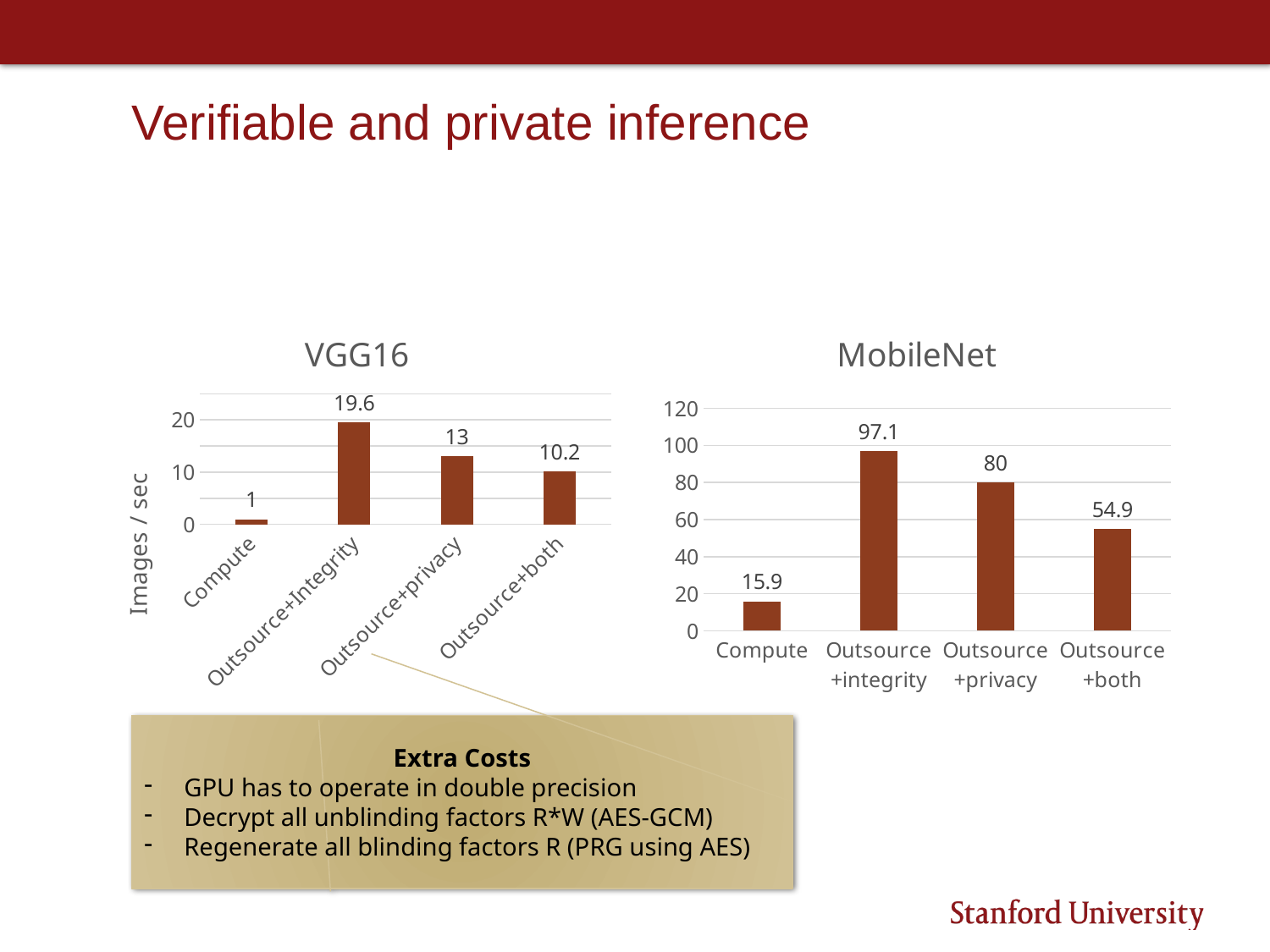
In the MobileNet chart, what is the value for Compute? 15.9 In the MobileNet chart, what is the difference between Outsource+integrity and Outsource+both? 42.2 In the MobileNet chart, which category has the highest value? Outsource+integrity In the MobileNet chart, is the value for Compute greater or less than 20? less What kind of chart is the VGG16 chart? bar chart In the MobileNet chart, what is the value for Outsource+privacy? 80 In the VGG16 chart, what is the value for Outsource+Integrity? 19.6 How many categories does the MobileNet chart show? 4 In the VGG16 chart, which is larger, Outsource+privacy or Outsource+both? Outsource+privacy In the VGG16 chart, which category has the lowest value? Compute What is the y-axis label of the VGG16 chart? Images / sec In the VGG16 chart, what is the difference between Outsource+privacy and Outsource+both? 2.8